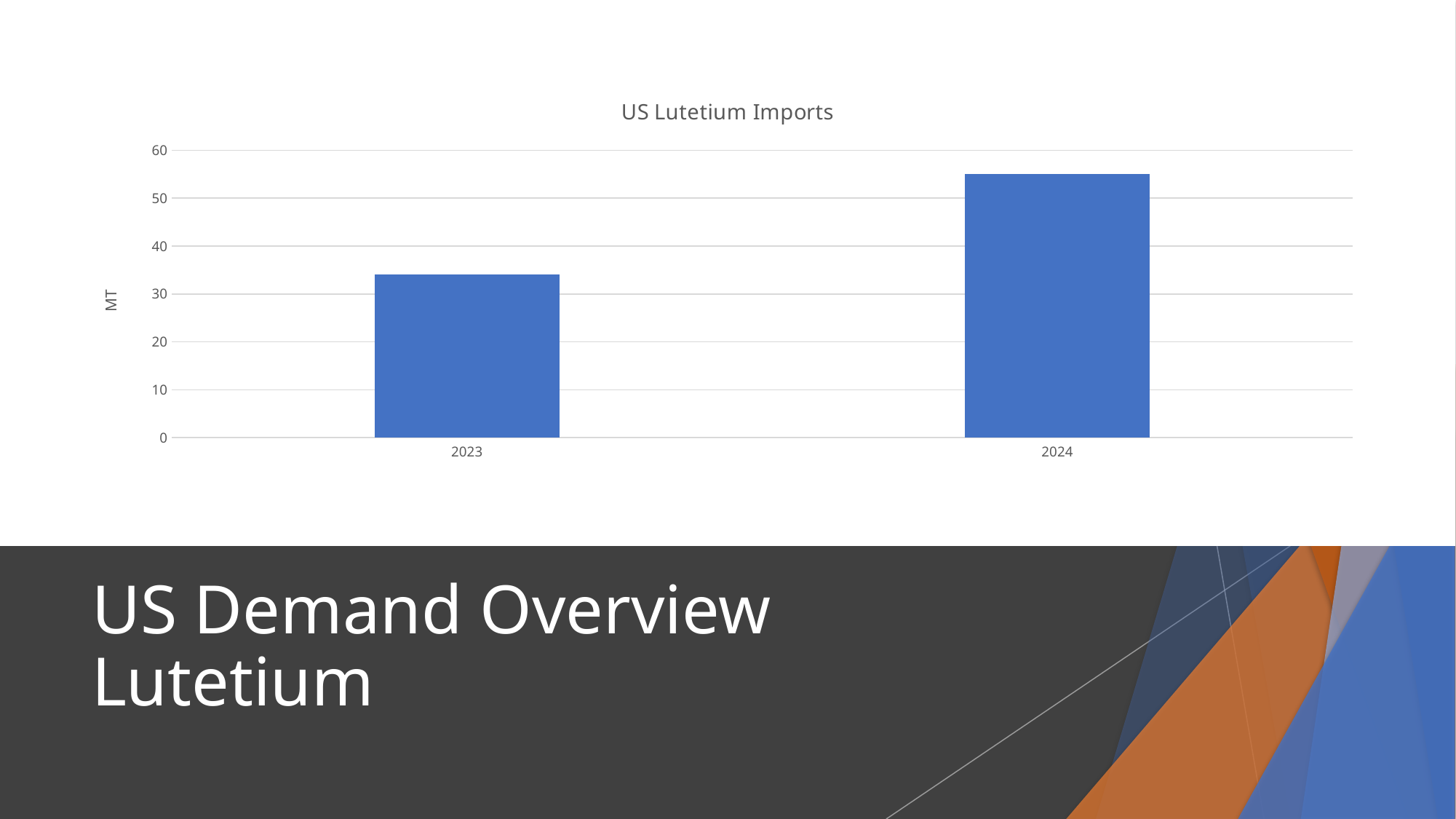
How many categories are shown on the x axis? 2 Is the value for 2023 greater or less than 30? greater Is the value for 2023 greater or less than 40? less Which year has the lowest value? 2023 Is the value for 2024 greater or less than 60? less What type of chart is shown on the slide? bar chart Which is larger, the value for 2023 or the value for 2024? 2024 Which year has the highest value? 2024 What is the label on the vertical axis of the chart? MT What is the title of the chart? US Lutetium Imports Do the values rise or fall from 2023 to 2024? rise